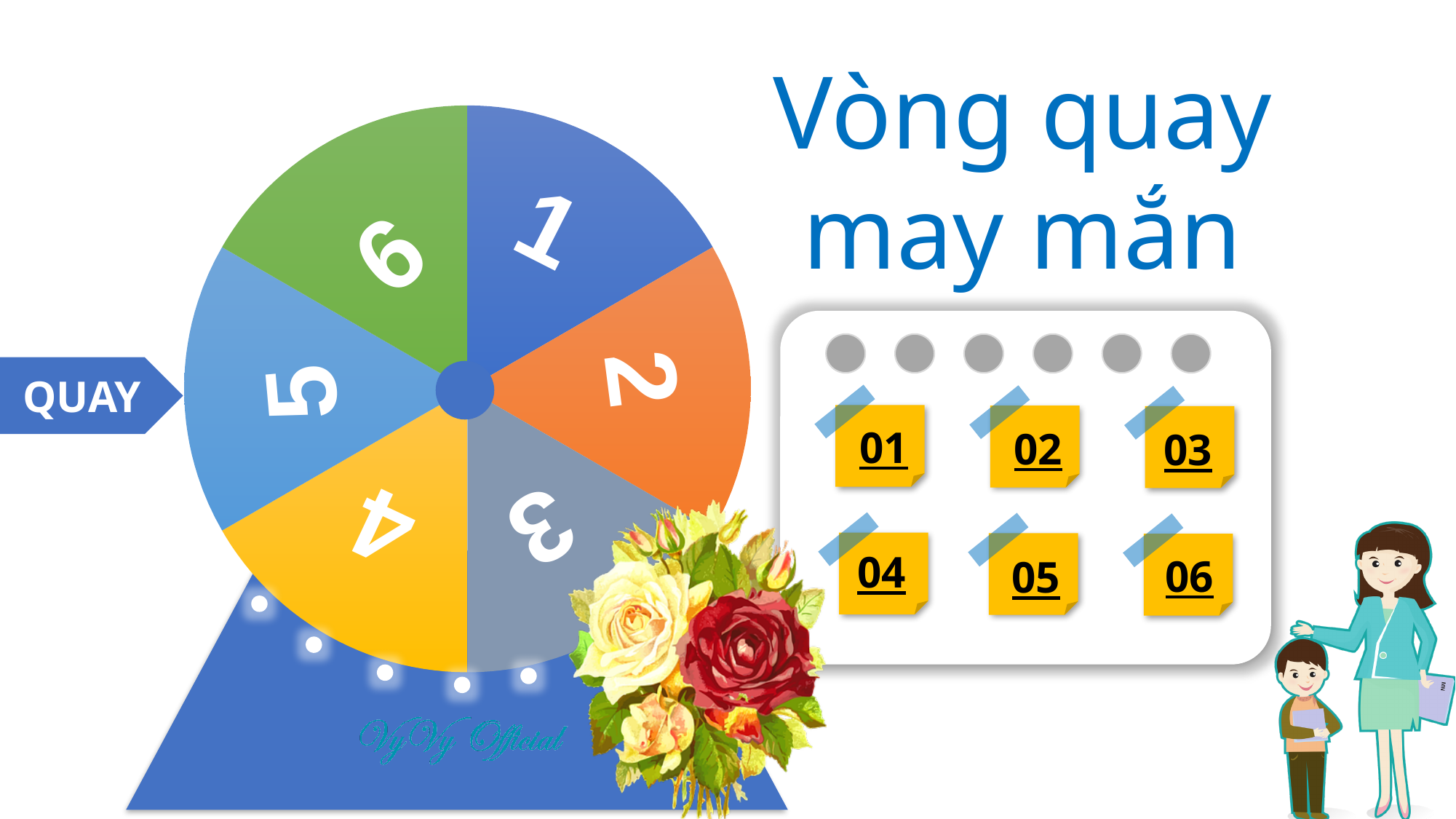
Which number is printed on the yellow segment of the wheel? 4 Which number is printed on the green segment of the wheel? 6 What colour is the segment labelled 2 on the wheel? orange Which number is printed on the grey segment of the wheel? 3 What kind of chart is the wheel on the left of the slide drawn as? pie chart What is the lowest number printed on any segment of the wheel? 1 What is the highest number printed on any segment of the wheel? 6 How many numbered yellow note cards are shown in the panel on the right of the slide? 6 How many segments does the wheel on the left of the slide have? 6 What is the title shown at the top right of the slide? Vòng quay may mắn